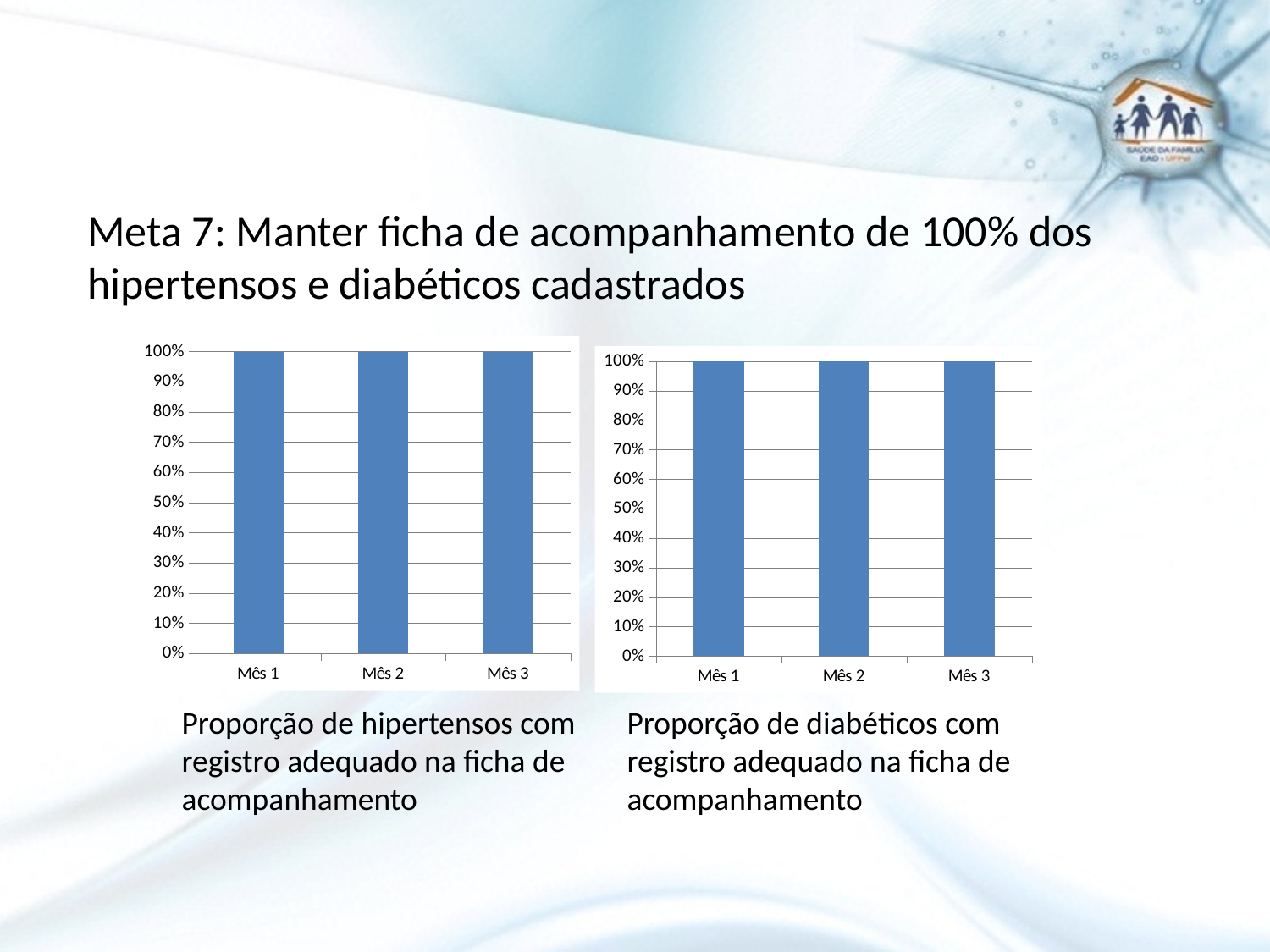
How many bars are plotted in the right chart (Proporção de diabéticos)? 3 What is the highest value shown on the y axis of the left chart (Proporção de hipertensos)? 100% What is the caption of the chart on the right side of the slide? Proporção de diabéticos com registro adequado na ficha de acompanhamento What kind of chart is the right chart (Proporção de diabéticos com registro adequado na ficha de acompanhamento)? Bar chart In the right chart (Proporção de diabéticos), is the value for Mês 2 greater or less than 50%? greater In the left chart (Proporção de hipertensos), do the values rise, fall or stay the same from Mês 1 to Mês 3? Stay the same In the left chart (Proporção de hipertensos com registro adequado na ficha de acompanhamento), what is the value for Mês 1? 100% In the right chart (Proporção de diabéticos com registro adequado na ficha de acompanhamento), what is the value for Mês 3? 100% How many categories are shown on the x axis of the left chart (Proporção de hipertensos)? 3 In the right chart (Proporção de diabéticos), what is the difference between the values for Mês 1 and Mês 3? 0% In the left chart (Proporção de hipertensos), what is the value for Mês 2? 100%